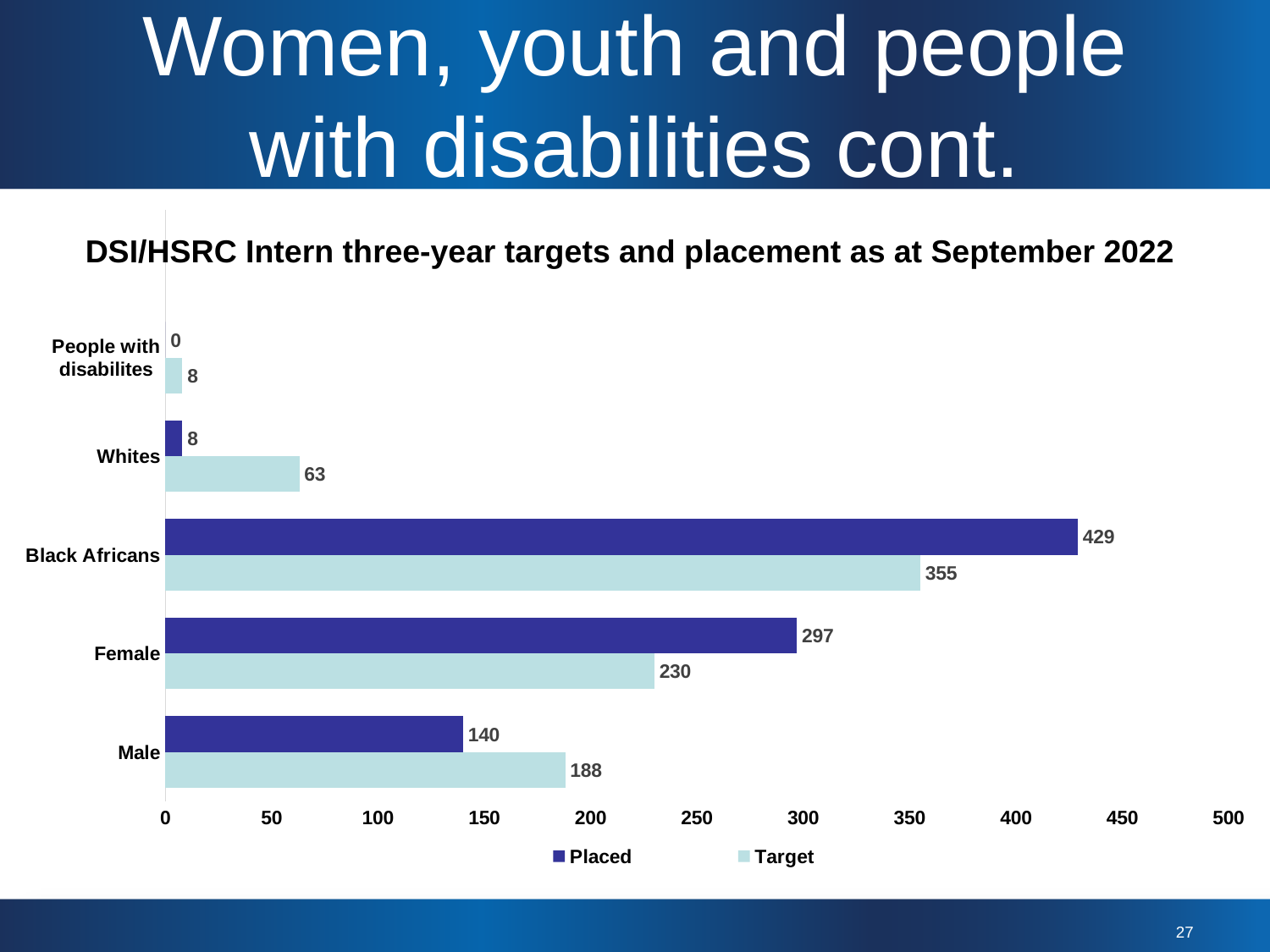
Which is larger for Whites, the Placed value or the Target value? Target Which category has the highest Target value? Black Africans What is the title of the chart? DSI/HSRC Intern three-year targets and placement as at September 2022 Is the Placed value for Female greater or less than 250? greater What is the Placed value for Black Africans? 429 What is the Target value for Female? 230 How many series does the legend list? 2 What is the Placed value for People with disabilites? 0 What kind of chart is shown on the slide? Bar chart How many categories are shown on the chart? 5 What is the difference between the Placed and Target values for Male? 48 Which category has the lowest Placed value? People with disabilites